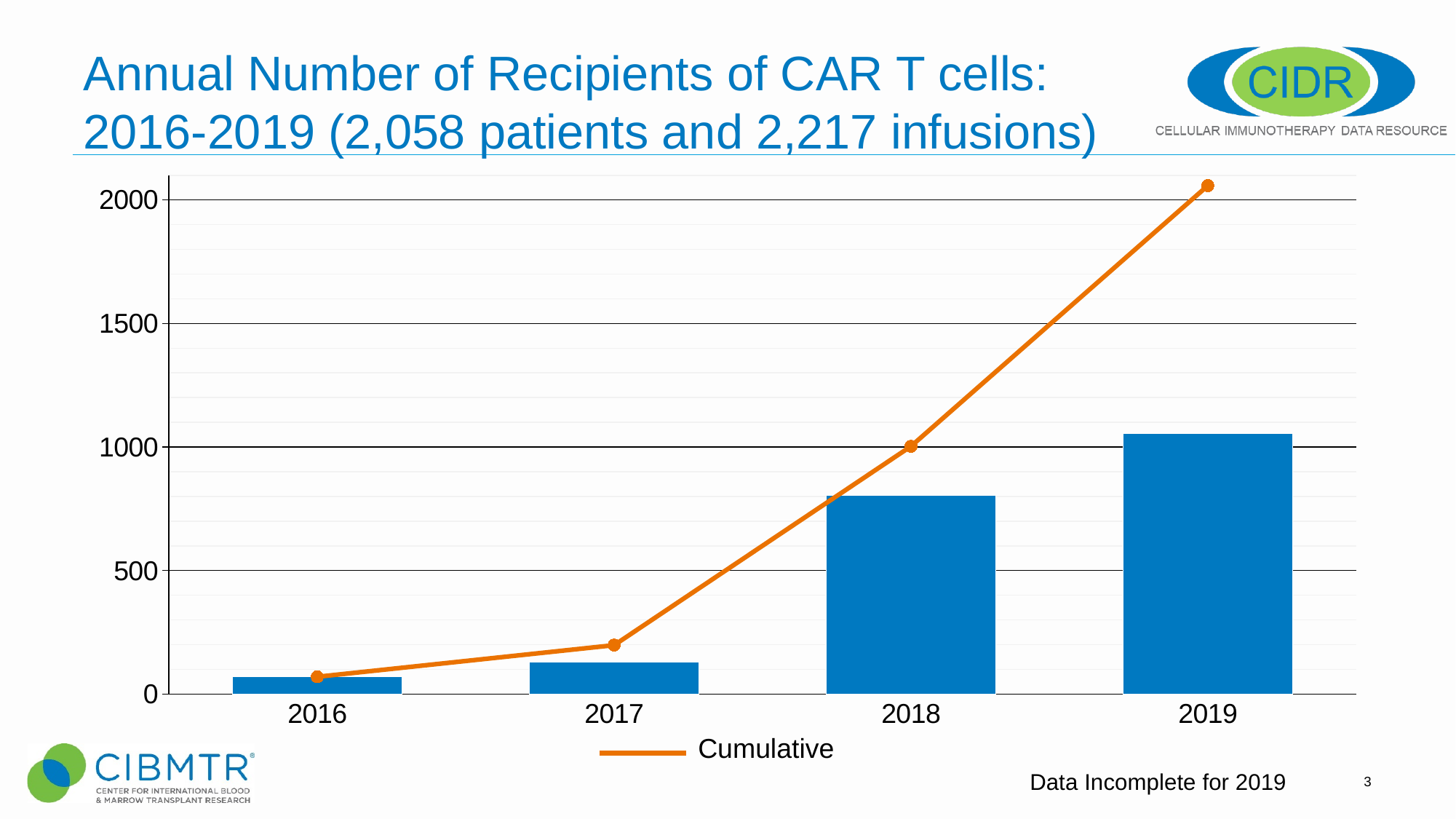
Do the annual bar values rise or fall from 2016 to 2019? Rise Is the bar value for 2019 greater or less than 1000? greater How many series does the chart's legend list? 1 What kind of chart is shown on the slide? Bar chart with a line What series name is shown in the chart's legend? Cumulative Which year has the shortest bar? 2016 Which year has the taller bar, 2017 or 2018? 2018 Is the Cumulative value for 2019 greater or less than 2000? greater Is the bar value for 2017 greater or less than 500? less Which year has the tallest bar? 2019 How many years are shown on the x axis of the chart? 4